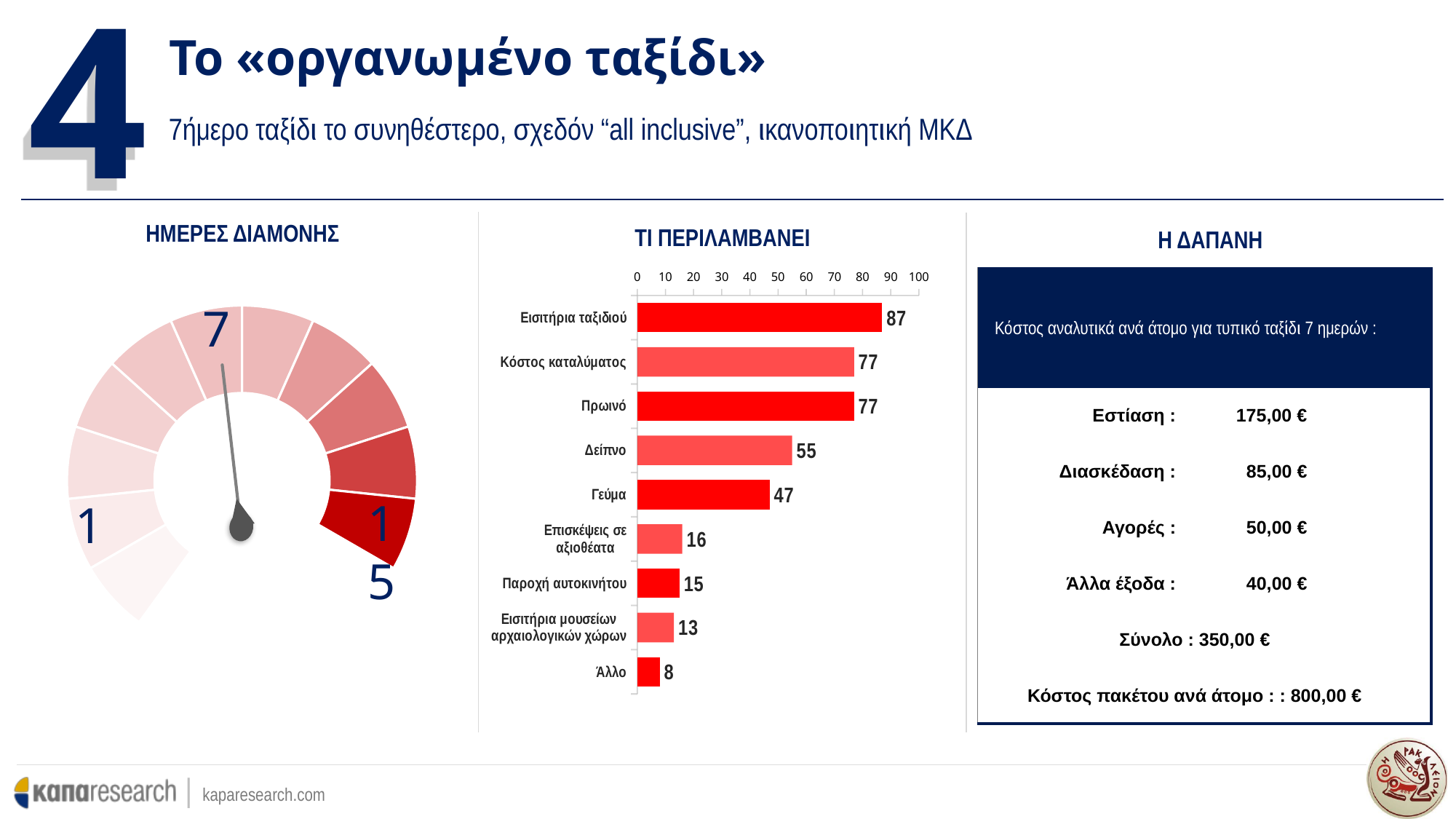
In the 'ΤΙ ΠΕΡΙΛΑΜΒΑΝΕΙ' chart, which is larger: Γεύμα or Επισκέψεις σε αξιοθέατα? Γεύμα What is the title of the gauge chart on the left of the slide? ΗΜΕΡΕΣ ΔΙΑΜΟΝΗΣ In the 'ΤΙ ΠΕΡΙΛΑΜΒΑΝΕΙ' chart, what is the difference between Δείπνο and Γεύμα? 8 In the 'ΤΙ ΠΕΡΙΛΑΜΒΑΝΕΙ' chart, what is the value for Εισιτήρια ταξιδιού? 87 In the 'ΤΙ ΠΕΡΙΛΑΜΒΑΝΕΙ' chart, which category has the highest value? Εισιτήρια ταξιδιού In the 'ΤΙ ΠΕΡΙΛΑΜΒΑΝΕΙ' chart, what is the value for Παροχή αυτοκινήτου? 15 In the 'ΤΙ ΠΕΡΙΛΑΜΒΑΝΕΙ' chart, what is the value for Δείπνο? 55 In the 'ΤΙ ΠΕΡΙΛΑΜΒΑΝΕΙ' chart, what is the difference between Εισιτήρια ταξιδιού and Κόστος καταλύματος? 10 In the 'ΤΙ ΠΕΡΙΛΑΜΒΑΝΕΙ' chart, is the value for Πρωινό greater or less than 70? greater In the 'ΤΙ ΠΕΡΙΛΑΜΒΑΝΕΙ' chart, which category has the lowest value? Άλλο How many categories are shown in the 'ΤΙ ΠΕΡΙΛΑΜΒΑΝΕΙ' chart? 9 What kind of chart is the 'ΤΙ ΠΕΡΙΛΑΜΒΑΝΕΙ' chart? Bar chart